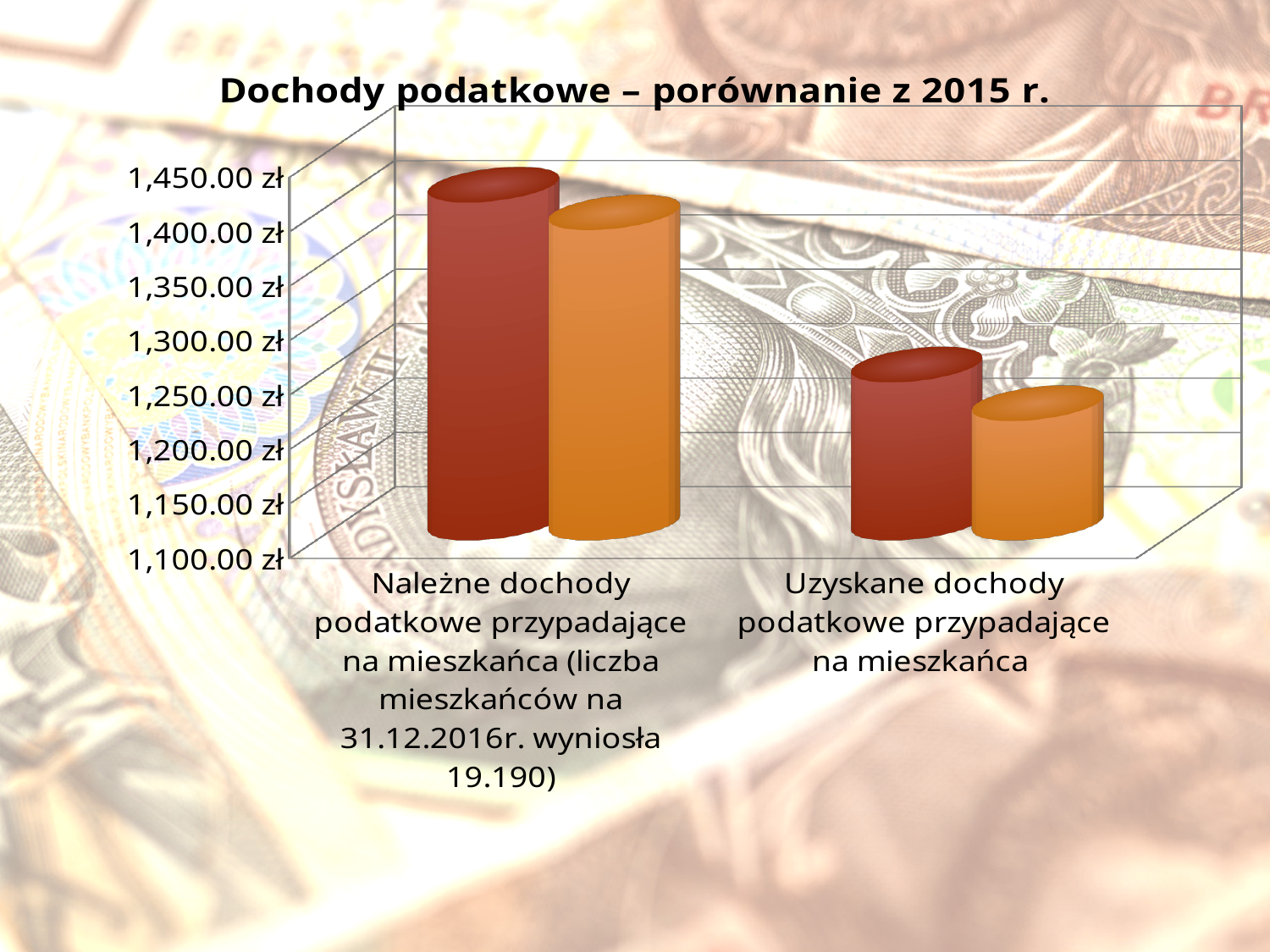
What kind of chart is shown on the slide? bar chart Do the bar values rise or fall from the left category to the right category? fall Within the 'Należne dochody podatkowe przypadające na mieszkańca' category, which bar is taller: the dark red one or the orange one? the dark red one How many bars are plotted for each category in the chart? 2 What is the title of the chart? Dochody podatkowe – porównanie z 2015 r. Which category has the taller orange bar? Należne dochody podatkowe przypadające na mieszkańca Is the orange bar for 'Należne dochody podatkowe przypadające na mieszkańca' greater or less than 1,300.00 zł? greater Is the dark red bar for 'Należne dochody podatkowe przypadające na mieszkańca' greater or less than 1,300.00 zł? greater How many categories are shown on the x axis of the chart? 2 Is the orange bar for 'Uzyskane dochody podatkowe przypadające na mieszkańca' greater or less than 1,350.00 zł? less Which category has the taller dark red bar: 'Należne dochody podatkowe przypadające na mieszkańca' or 'Uzyskane dochody podatkowe przypadające na mieszkańca'? Należne dochody podatkowe przypadające na mieszkańca